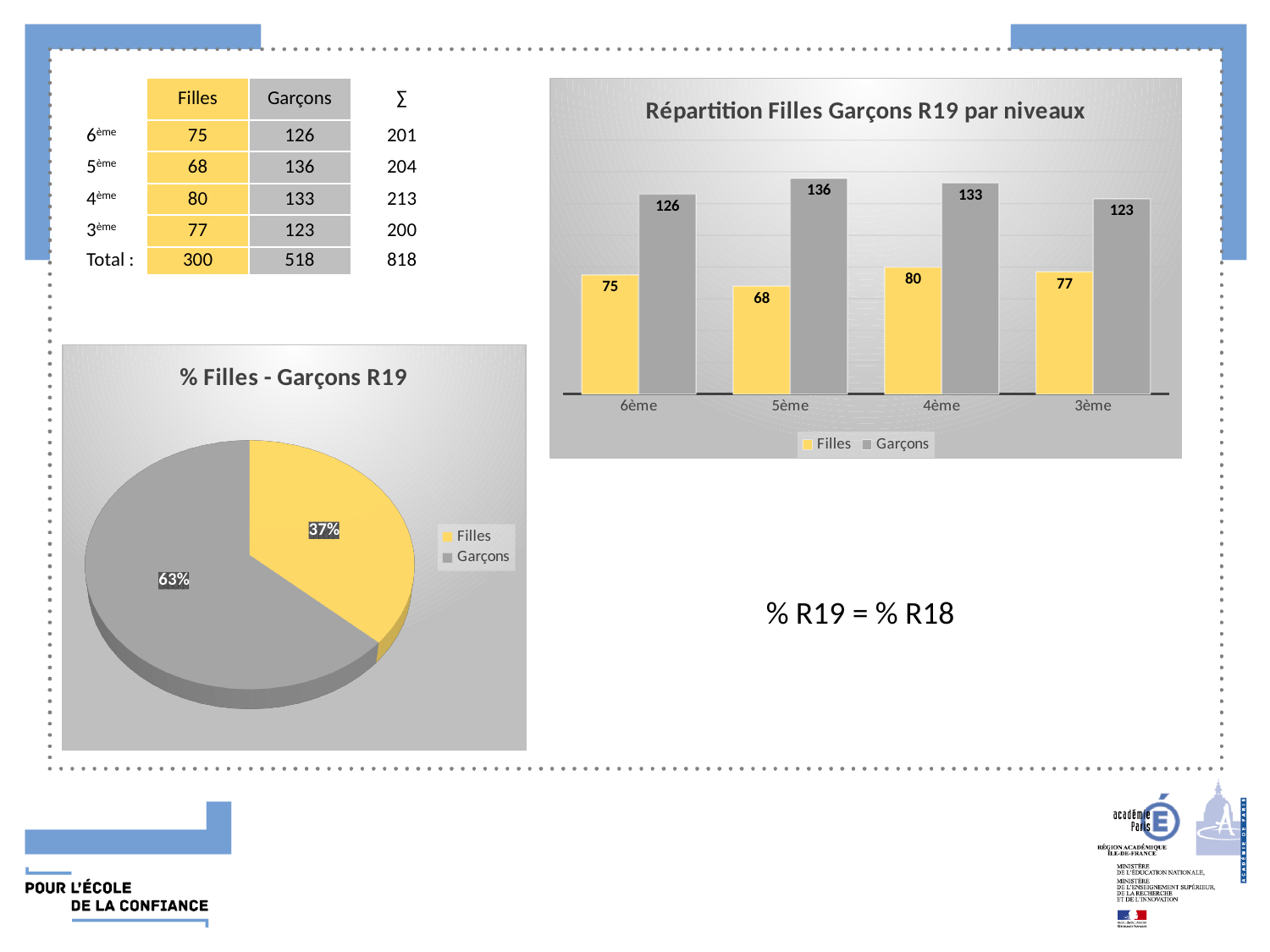
In the chart titled "Répartition Filles Garçons R19 par niveaux", which level has the lowest value for Filles? 5ème How many series does the legend list in the chart titled "Répartition Filles Garçons R19 par niveaux"? 2 In the chart titled "Répartition Filles Garçons R19 par niveaux", is the value for Filles in 3ème larger or smaller than the value for Filles in 4ème? smaller In the chart titled "% Filles - Garçons R19", what share of the pie is Garçons? 63% What kind of chart is the one titled "Répartition Filles Garçons R19 par niveaux"? bar chart In the chart titled "Répartition Filles Garçons R19 par niveaux", what is the value for Garçons in 5ème? 136 In the chart titled "Répartition Filles Garçons R19 par niveaux", what is the difference between Garçons and Filles in 6ème? 51 In the chart titled "Répartition Filles Garçons R19 par niveaux", what is the value for Filles in 4ème? 80 What kind of chart is the one titled "% Filles - Garçons R19"? pie chart In the chart titled "Répartition Filles Garçons R19 par niveaux", which level has the highest value for Garçons? 5ème In the chart titled "% Filles - Garçons R19", what share of the pie is Filles? 37% How many levels are shown on the x axis of the chart titled "Répartition Filles Garçons R19 par niveaux"? 4